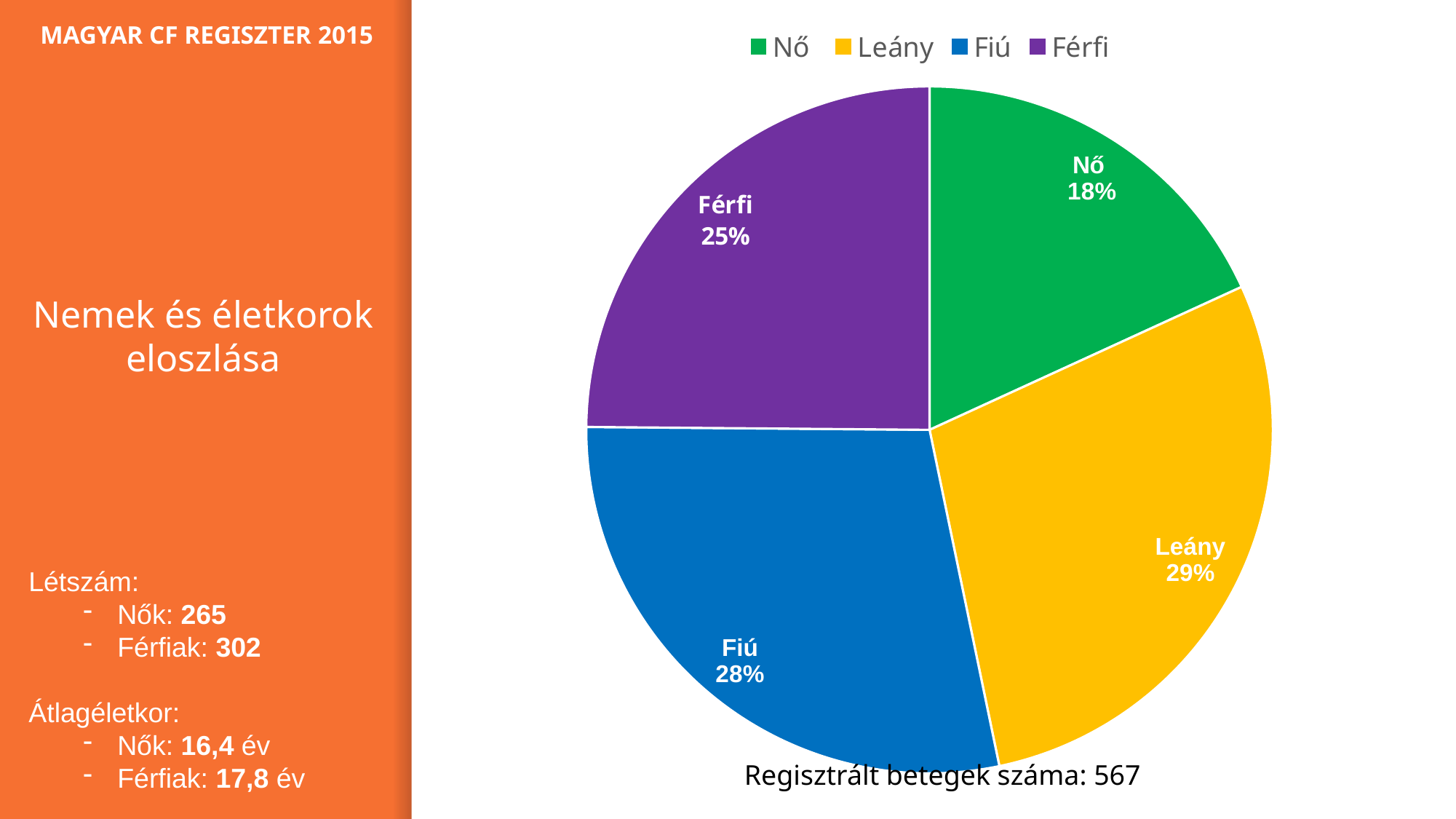
What is the difference in percentage points between the Leány and Nő slices? 11 What share of the pie does the Férfi slice represent? 25% Which slice is larger, Férfi or Nő? Férfi What kind of chart is shown on the slide? Pie chart Which slice of the pie is the smallest? Nő Which slice of the pie is the largest? Leány What share of the pie does the Nő slice represent? 18% How many entries does the legend list? 4 What share of the pie does the Fiú slice represent? 28% How many slices does the pie chart have? 4 What share of the pie does the Leány slice represent? 29% What colour is the Fiú slice? Blue